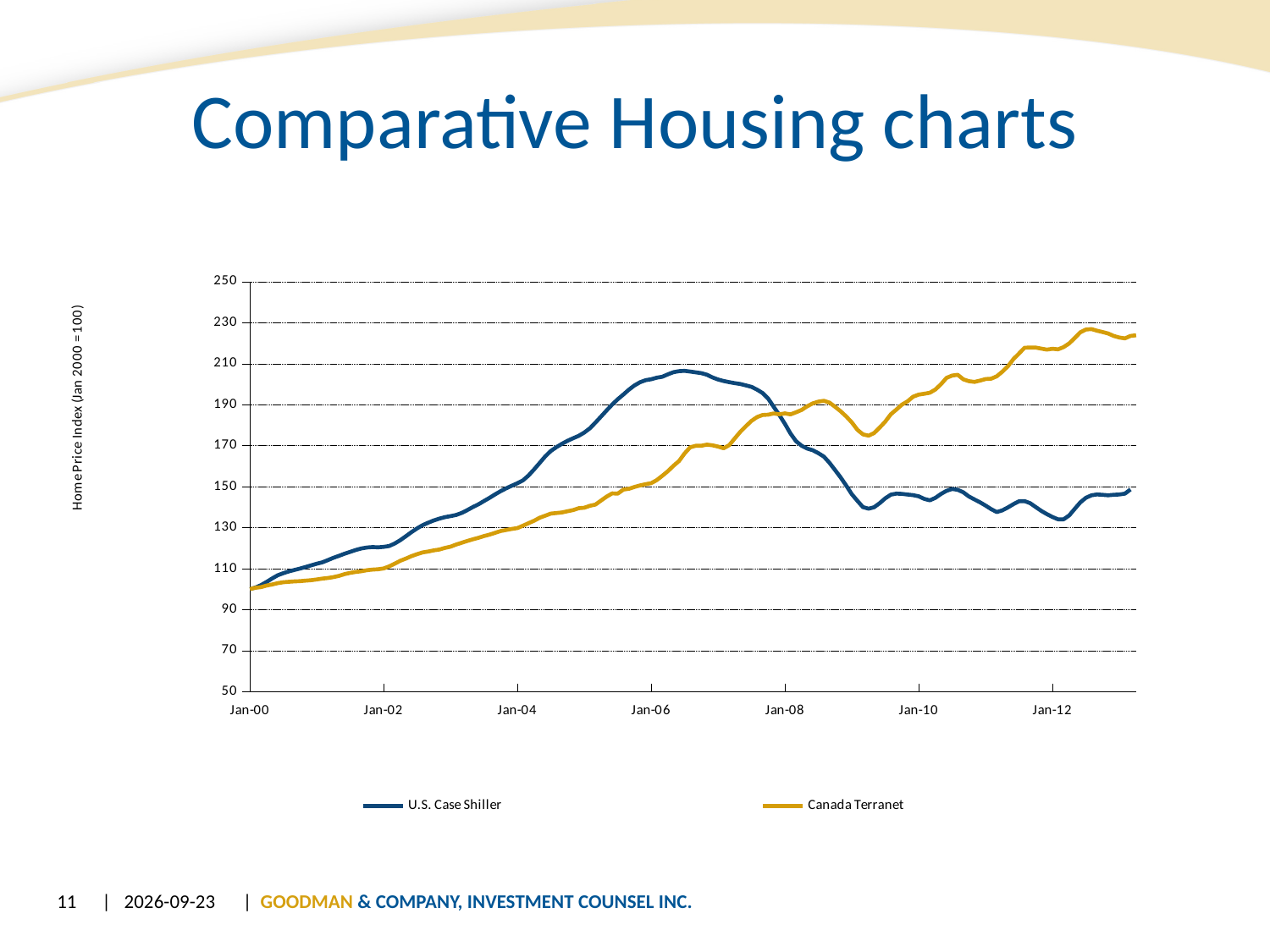
What is the title of the slide's chart? Comparative Housing charts At Jan-06, which series has the higher value, U.S. Case Shiller or Canada Terranet? U.S. Case Shiller Does the U.S. Case Shiller line rise or fall between Jan-06 and Jan-10? Fall Is the value for U.S. Case Shiller at Jan-06 greater or less than 170? greater How many series does the legend list? 2 Which series reaches the higher peak value over the whole chart? Canada Terranet What kind of chart is shown on the slide? Line chart Is the value for Canada Terranet at Jan-04 greater or less than 150? less What is the label on the vertical axis? Home Price Index (Jan 2000 = 100) Is the value for Canada Terranet at Jan-12 greater or less than 210? greater At Jan-12, which series has the higher value, U.S. Case Shiller or Canada Terranet? Canada Terranet